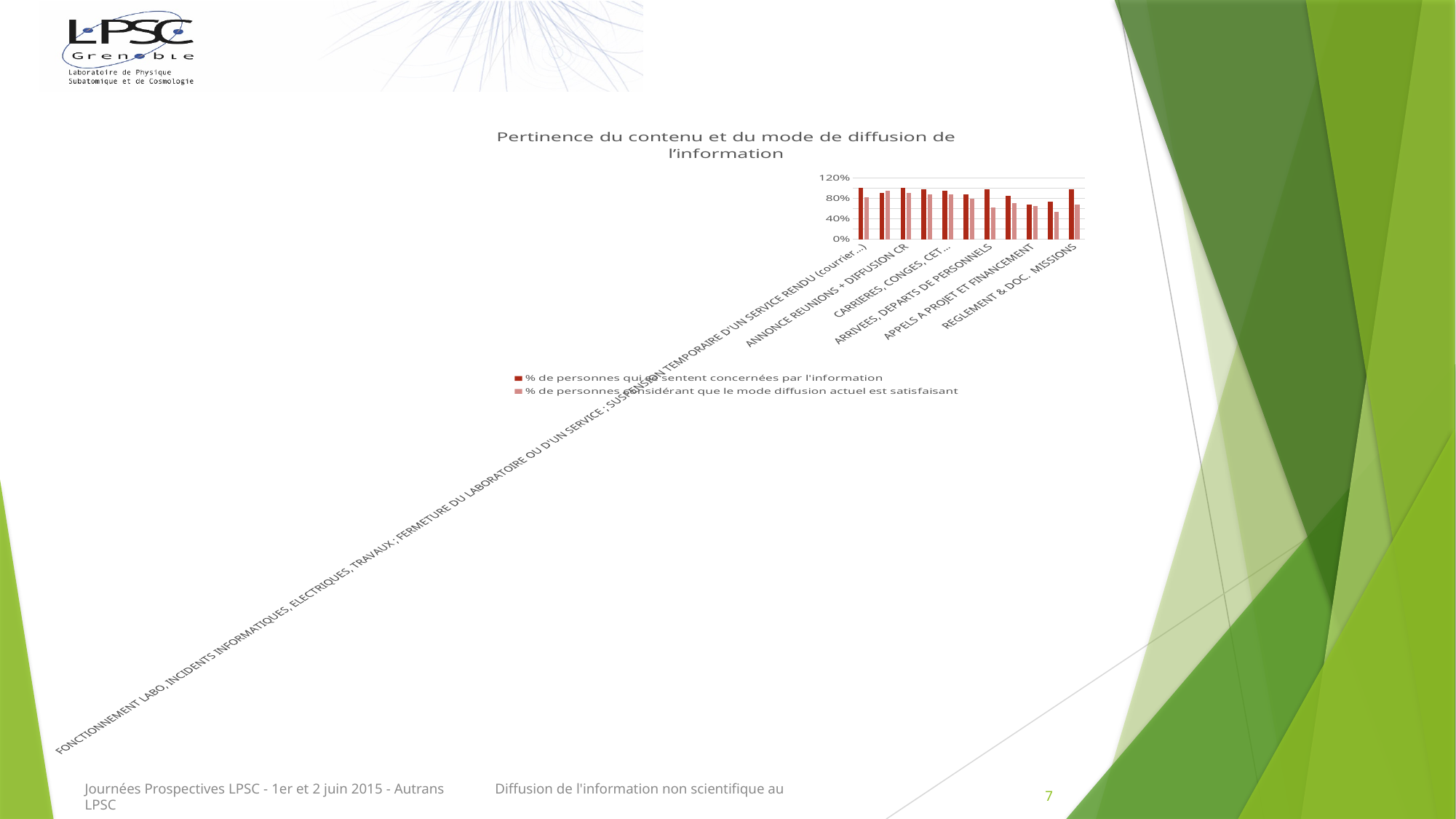
Is the value of '% de personnes qui se sentent concernées par l'information' for REGLEMENT & DOC. MISSIONS greater or less than 80%? greater What is the highest value shown on the vertical axis of the chart? 120% What is the title of the chart? Pertinence du contenu et du mode de diffusion de l'information Is the value of '% de personnes qui se sentent concernées par l'information' for APPELS A PROJET ET FINANCEMENT greater or less than 80%? less What kind of chart is shown on the slide? bar chart Is the value of '% de personnes considérant que le mode diffusion actuel est satisfaisant' for REGLEMENT & DOC. MISSIONS greater or less than 80%? less What is the first legend entry of the chart? % de personnes qui se sentent concernées par l'information For ARRIVEES, DEPARTS DE PERSONNELS, which series has the larger value: '% de personnes qui se sentent concernées par l'information' or '% de personnes considérant que le mode diffusion actuel est satisfaisant'? % de personnes qui se sentent concernées par l'information How many series does the legend list? 2 For REGLEMENT & DOC. MISSIONS, which series has the larger value: '% de personnes qui se sentent concernées par l'information' or '% de personnes considérant que le mode diffusion actuel est satisfaisant'? % de personnes qui se sentent concernées par l'information